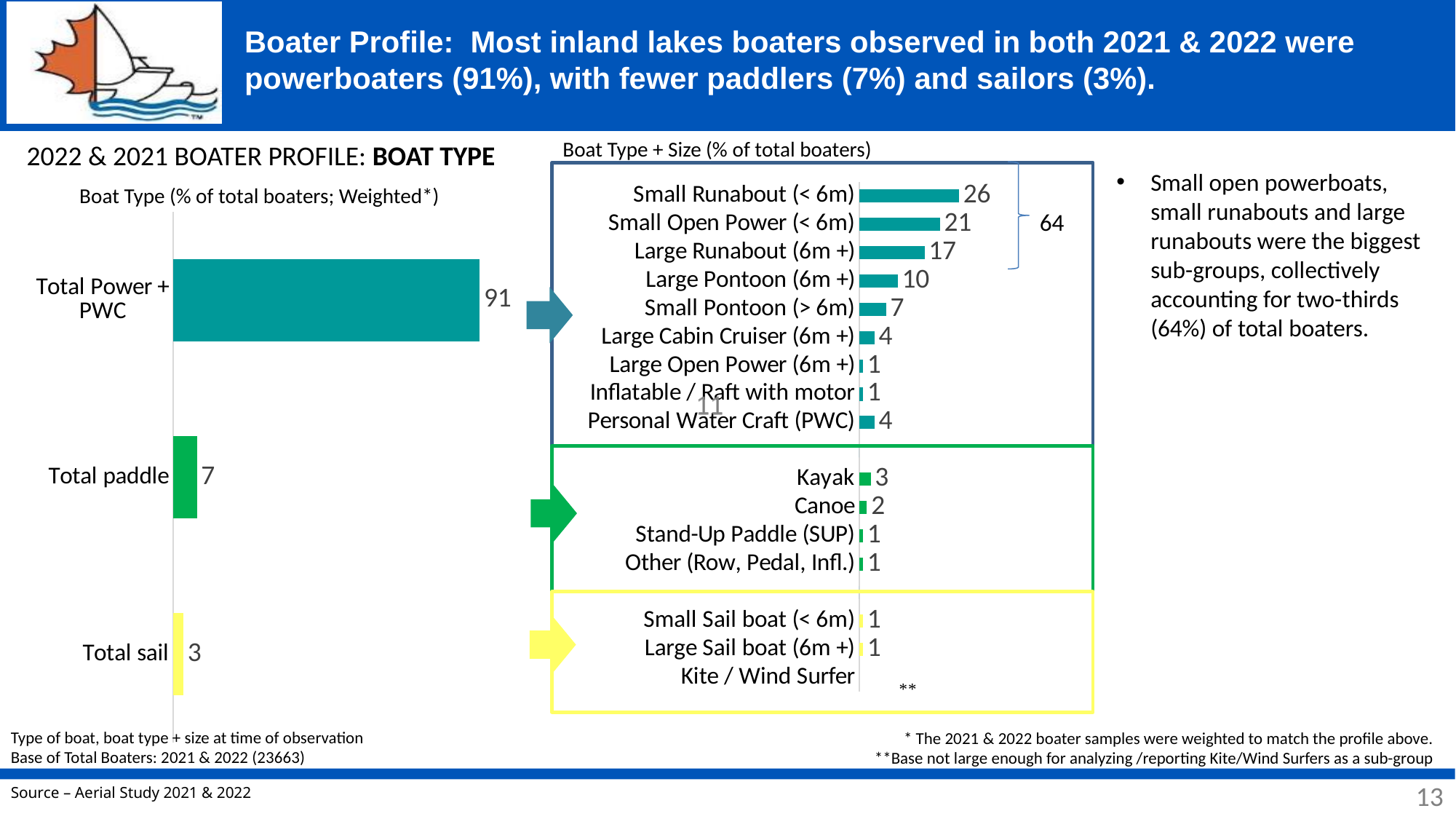
In the 'Boat Type + Size (% of total boaters)' chart on the right, what combined value is shown by the bracket for Small Runabout, Small Open Power and Large Runabout? 64 In the 'Boat Type + Size (% of total boaters)' chart on the right, what is the value for Small Runabout (< 6m)? 26 In the 'Boat Type + Size (% of total boaters)' chart on the right, which category has the highest value? Small Runabout (< 6m) In the 'Boat Type (% of total boaters; Weighted*)' chart on the left, which category has the lowest value? Total sail In the 'Boat Type + Size (% of total boaters)' chart on the right, what is the value for Large Pontoon (6m +)? 10 In the 'Boat Type (% of total boaters; Weighted*)' chart on the left, how many categories are shown? 3 In the 'Boat Type + Size (% of total boaters)' chart on the right, what is the difference between Kayak and Canoe? 1 In the 'Boat Type (% of total boaters; Weighted*)' chart on the left, what is the difference between Total Power + PWC and Total paddle? 84 What kind of chart is the 'Boat Type + Size (% of total boaters)' chart on the right? Bar chart In the 'Boat Type (% of total boaters; Weighted*)' chart on the left, what is the value for Total Power + PWC? 91 In the 'Boat Type + Size (% of total boaters)' chart on the right, which is larger: Small Open Power (< 6m) or Large Runabout (6m +)? Small Open Power (< 6m) In the 'Boat Type (% of total boaters; Weighted*)' chart on the left, what is the value for Total paddle? 7